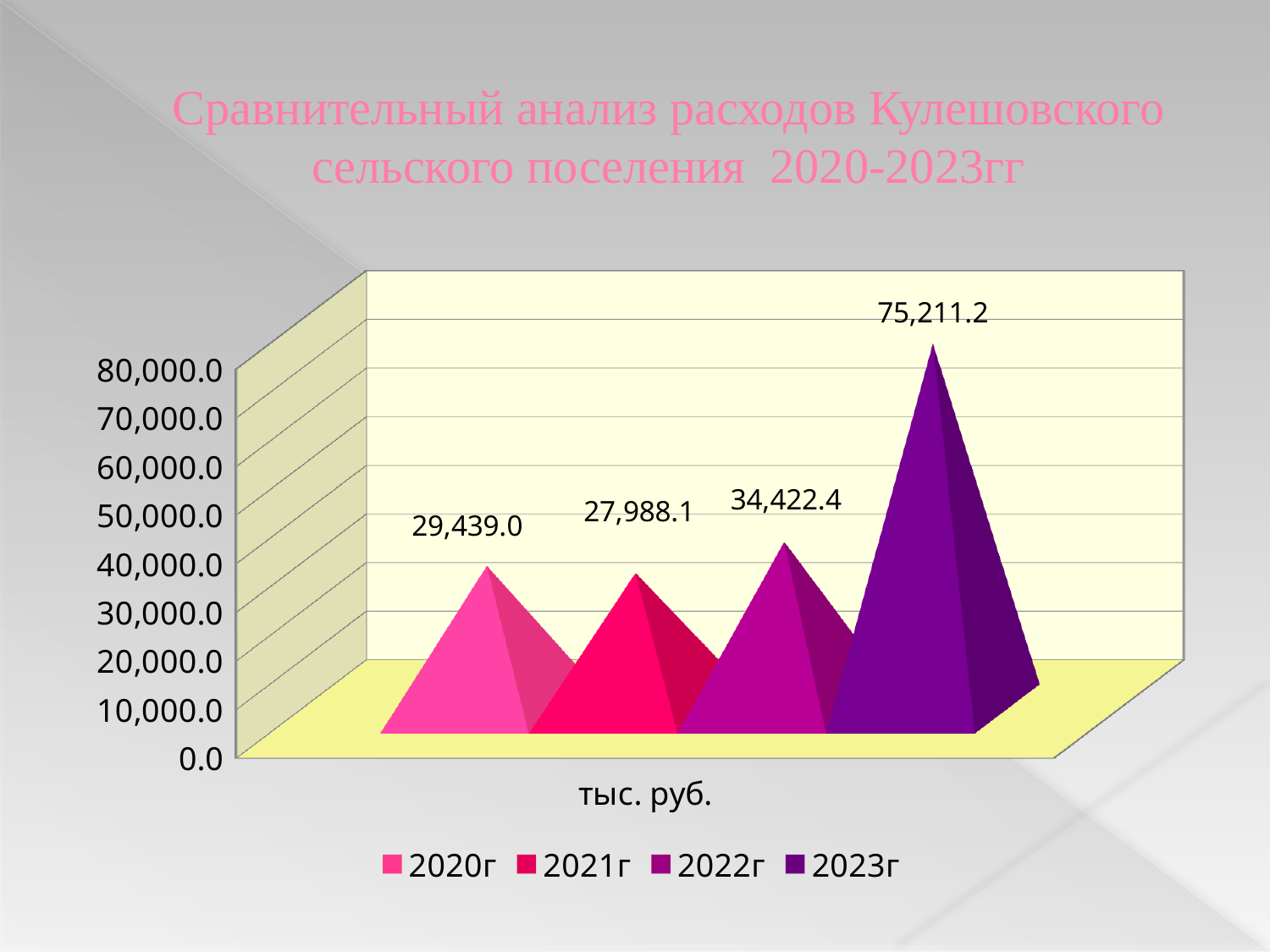
How many series does the legend list? 4 What is the value for 2020г? 29,439.0 Which year has the lowest value? 2021г What kind of chart is shown on the slide? bar chart What is the value for 2021г? 27,988.1 Is the value for 2023г greater or less than 70,000.0? greater What is the label shown under the category axis of the chart? тыс. руб. What is the value for 2023г? 75,211.2 What is the difference between the values for 2023г and 2022г? 40,788.8 Which is larger, the value for 2020г or the value for 2021г? 2020г Which year has the highest value? 2023г What is the value for 2022г? 34,422.4